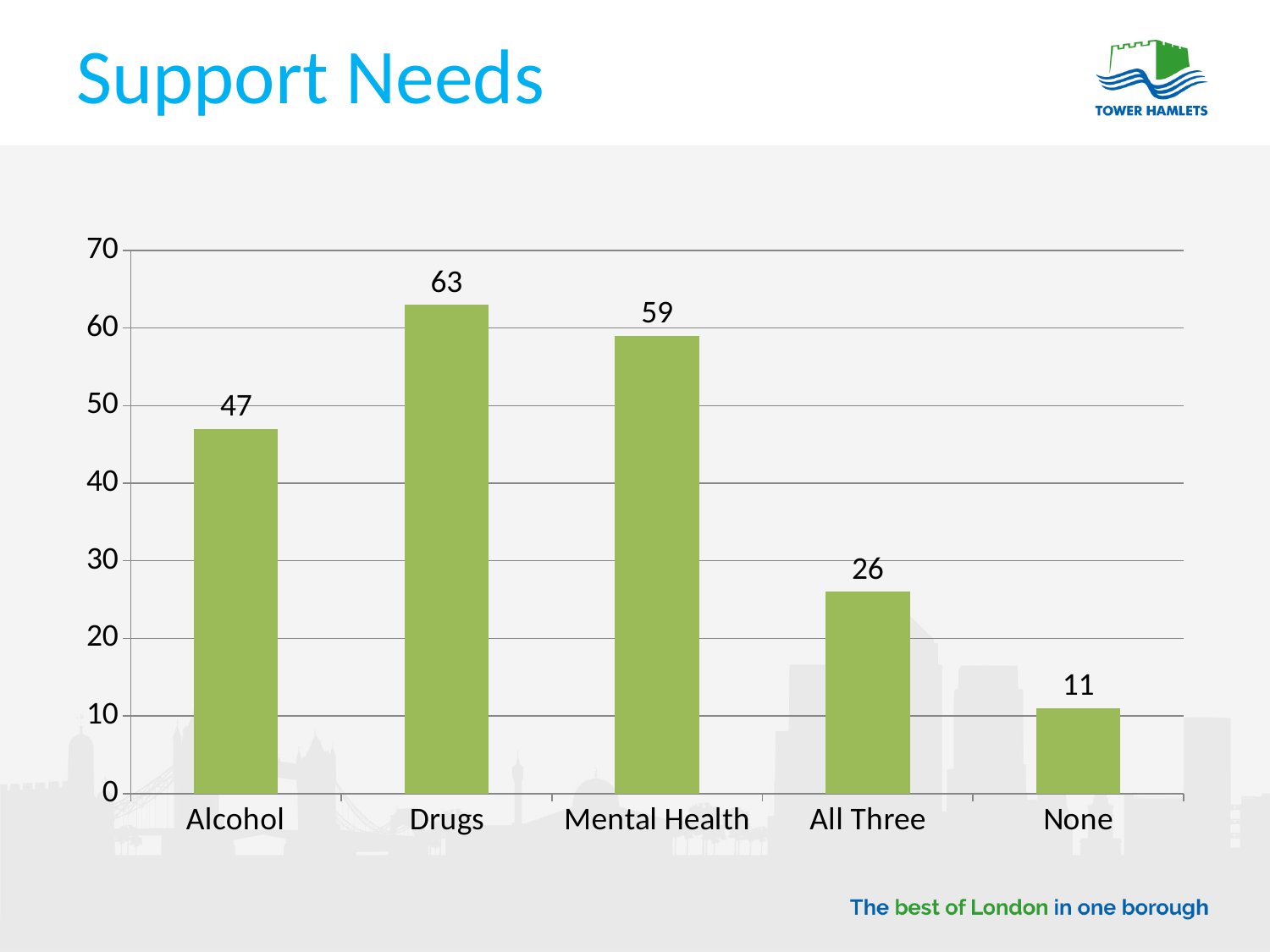
What is the value for Drugs? 63 What is the value for Alcohol? 47 What kind of chart is shown on the slide? bar chart What is the title of the slide containing the chart? Support Needs What is the difference between the values for Alcohol and All Three? 21 Is the value for All Three greater or less than 30? less Which is larger, the value for Alcohol or the value for Mental Health? Mental Health Which category has the lowest value? None How many categories are shown on the x axis? 5 Which category has the highest value? Drugs What is the difference between the values for Drugs and Mental Health? 4 What is the value for None? 11